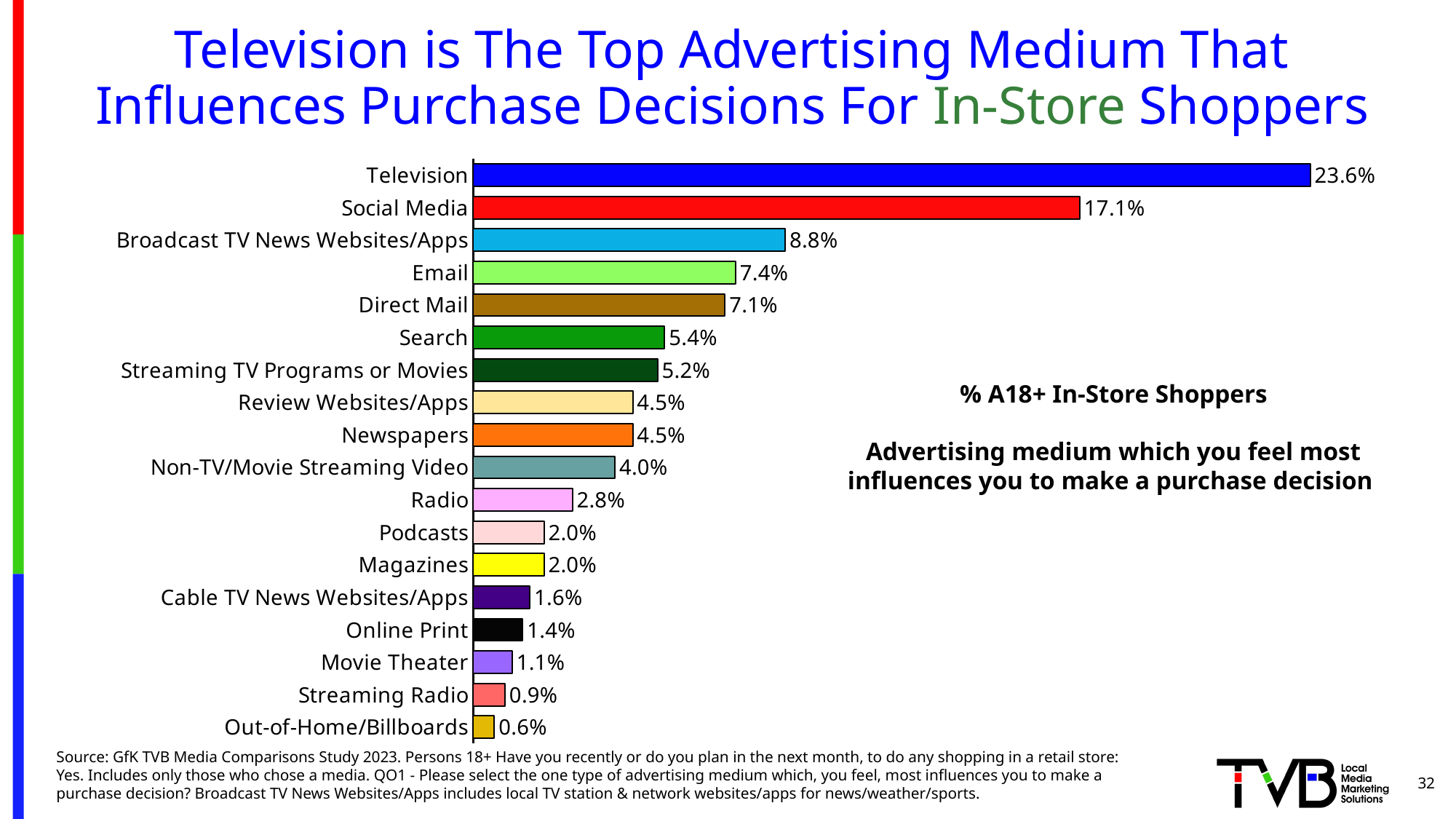
What is the difference between the values for Broadcast TV News Websites/Apps and Email? 1.4% Which advertising medium has the highest value on the chart? Television What percentage of A18+ in-store shoppers chose Television as the advertising medium that most influences their purchase decision? 23.6% How many advertising media categories are shown on the chart? 18 What is the value shown for Direct Mail? 7.1% What kind of chart is shown on the slide? Bar chart Which has a larger value, Email or Search? Email Which advertising medium has the lowest value on the chart? Out-of-Home/Billboards Which two categories both show a value of 4.5%? Review Websites/Apps and Newspapers What colour is the bar for Television? Blue What is the difference between the values for Television and Social Media? 6.5% What is the value shown for Social Media? 17.1%